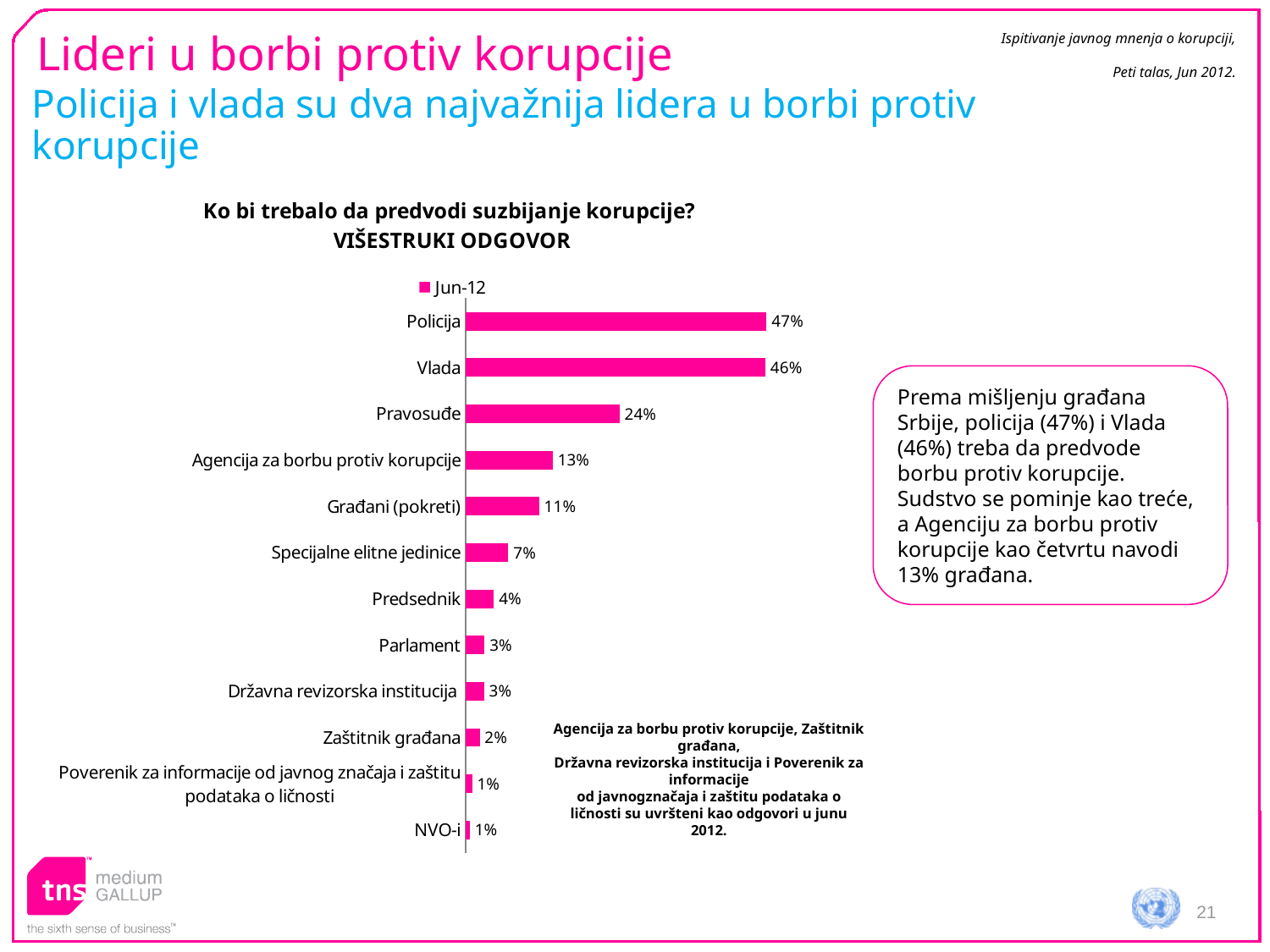
What is the difference between the values for Policija and Vlada? 1% What is the value for Agencija za borbu protiv korupcije? 13% What is the value for Policija? 47% Which is larger, the value for Specijalne elitne jedinice or the value for Predsednik? Specijalne elitne jedinice How many categories are shown in the chart? 12 What is the legend entry of the chart? Jun-12 How many series does the legend list? 1 What is the value for Pravosuđe? 24% What is the difference between the values for Pravosuđe and Građani (pokreti)? 13% What kind of chart is shown? bar chart What is the value for Zaštitnik građana? 2% Which category has the highest value? Policija